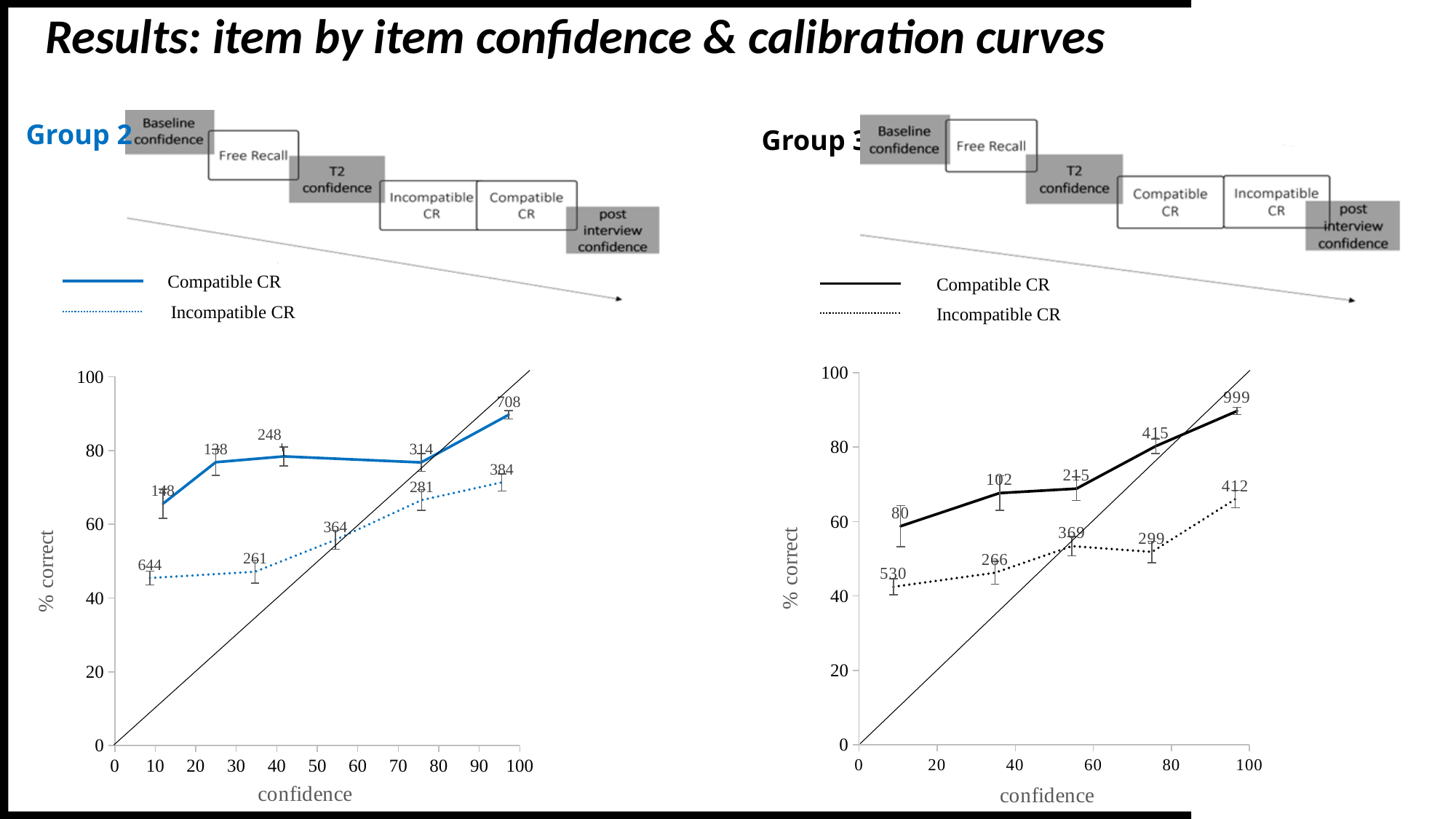
What type of chart is the Group 2 chart? line chart In the Group 2 chart, what is the data label on the Compatible CR point at the highest confidence level? 708 In the Group 2 chart, at the highest confidence level, which series has the higher % correct: Compatible CR or Incompatible CR? Compatible CR What is the label on the y axis of the Group 3 chart? % correct In the Group 3 chart, what is the data label on the Incompatible CR point at the lowest confidence level? 530 In the Group 3 chart, what is the data label on the Compatible CR point at the highest confidence level? 999 In the Group 3 chart, does the % correct for Compatible CR rise or fall as confidence increases? rise In the Group 2 chart, which series is drawn with a dotted line? Incompatible CR In the Group 2 chart, how many data points are plotted on the Compatible CR line? 5 How many series does the legend of the Group 3 chart list? 2 In the Group 2 chart, is the % correct for Compatible CR at the highest confidence level greater or less than 80? greater In the Group 3 chart, is the % correct for Incompatible CR at the lowest confidence level greater or less than 60? less